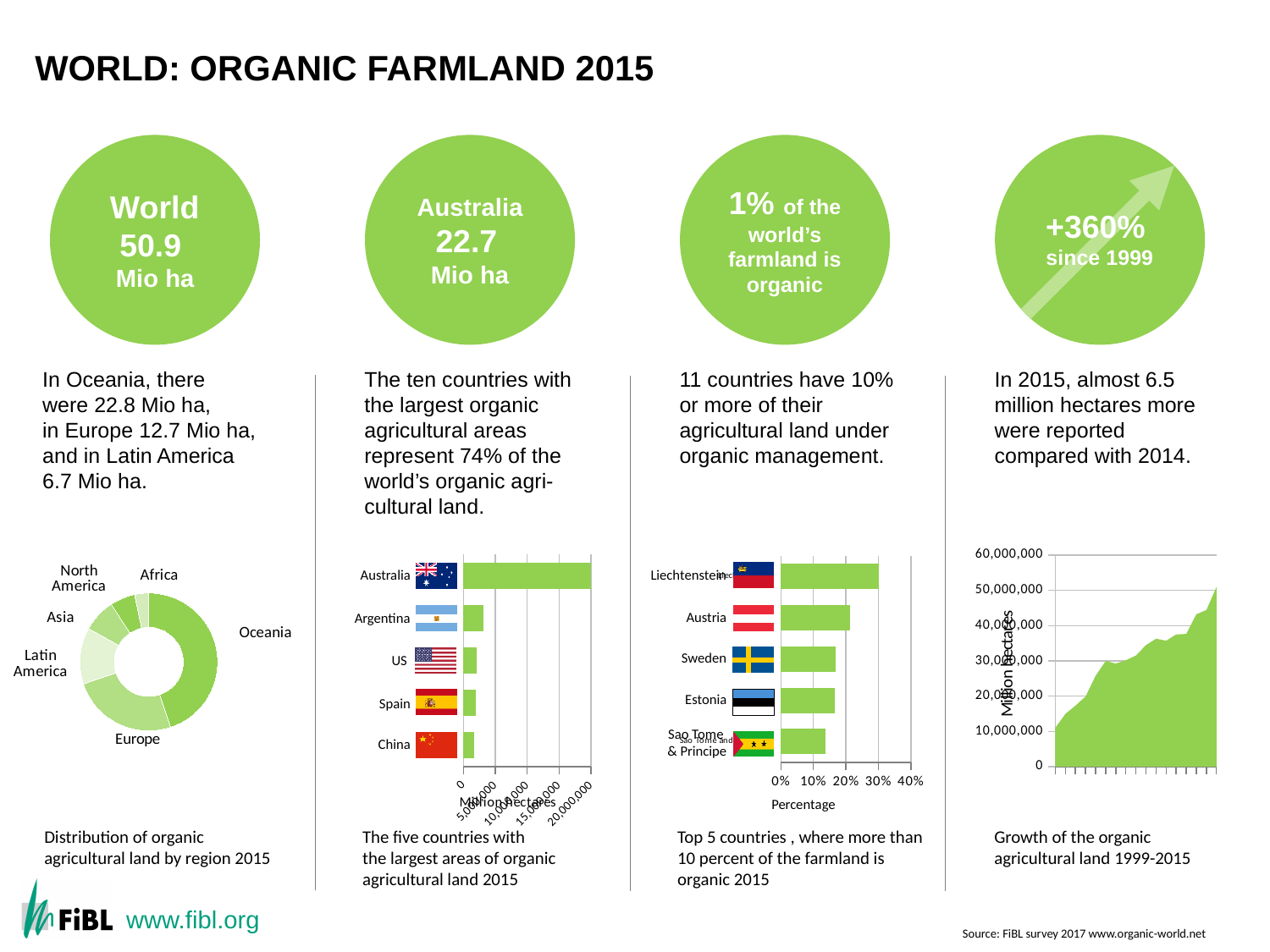
In the 'Distribution of organic agricultural land by region 2015' chart, which region has the largest slice? Oceania In the 'Top 5 countries, where more than 10 percent of the farmland is organic 2015' chart, how many countries are shown? 5 In the 'Growth of the organic agricultural land 1999-2015' chart, do the values rise or fall from 1999 to 2015? rise In 'The five countries with the largest areas of organic agricultural land 2015' chart, is the value for Australia greater or less than 20,000,000? greater In the 'Distribution of organic agricultural land by region 2015' chart, how many regions are shown? 6 In the 'Top 5 countries, where more than 10 percent of the farmland is organic 2015' chart, is the value for Sweden greater or less than 20%? less In the 'Top 5 countries, where more than 10 percent of the farmland is organic 2015' chart, which is larger, Liechtenstein or Sweden? Liechtenstein In 'The five countries with the largest areas of organic agricultural land 2015' chart, is the value for Argentina greater or less than 5,000,000? less In the 'Top 5 countries, where more than 10 percent of the farmland is organic 2015' chart, which country has the highest value? Liechtenstein What kind of chart is 'The five countries with the largest areas of organic agricultural land 2015'? bar chart In 'The five countries with the largest areas of organic agricultural land 2015' chart, which country has the highest value? Australia What kind of chart is the 'Distribution of organic agricultural land by region 2015' chart? doughnut chart